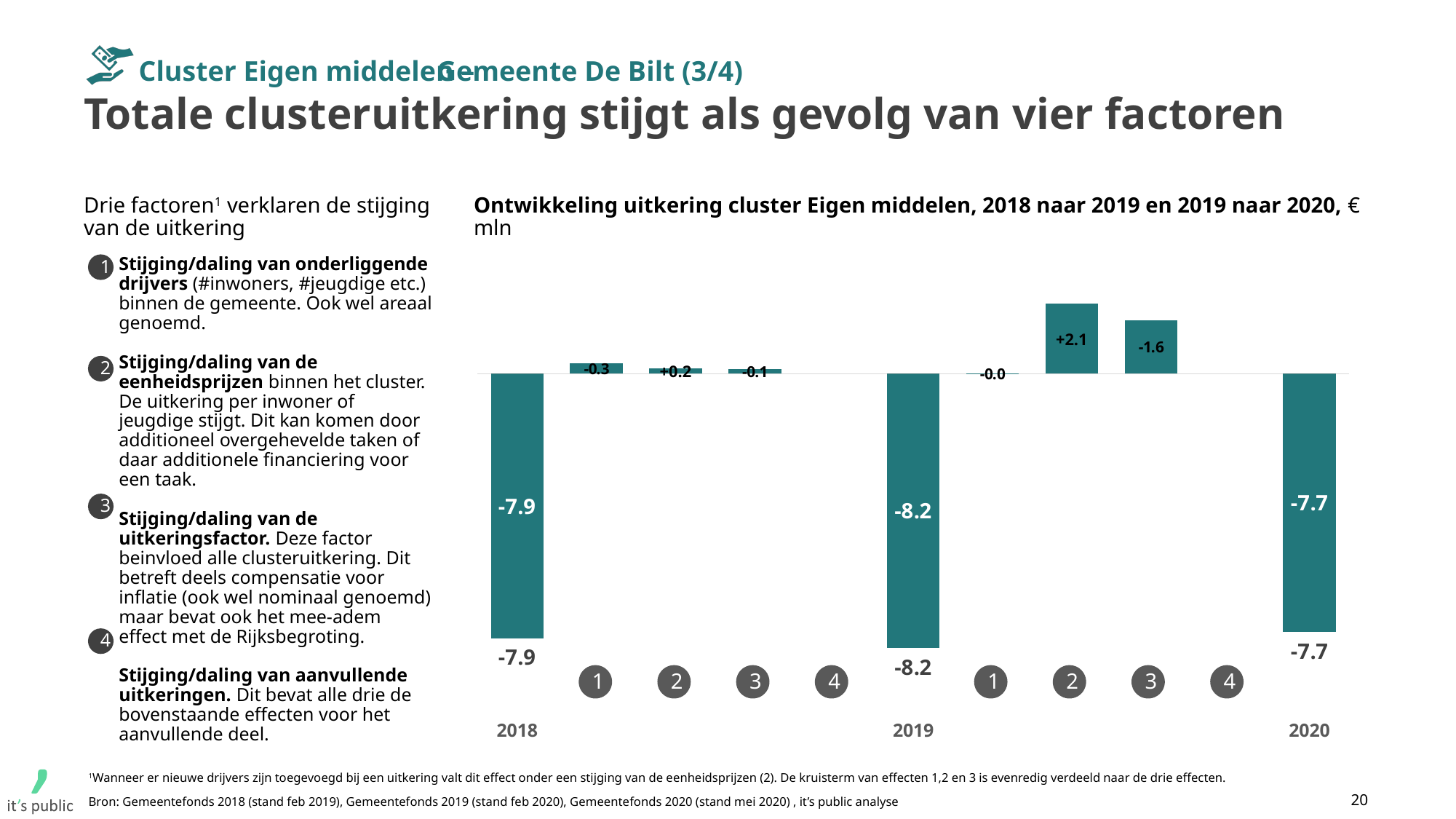
What is the value shown for 2019 in the chart? -8.2 What is the value of factor 3 between 2019 and 2020? -1.6 Which is larger in absolute size: factor 2 between 2019 and 2020 or factor 3 between 2019 and 2020? Factor 2 (+2.1) What is the value of factor 2 between 2019 and 2020? +2.1 What is the value shown for 2020 in the chart? -7.7 What unit is stated in the chart title? € mln What is the value shown for 2018 in the chart? -7.9 What kind of chart is shown on the slide? Bar chart (waterfall) What is the value of factor 2 between 2018 and 2019? +0.2 Which of the three years (2018, 2019, 2020) has the lowest value? 2019 What is the difference between the 2020 value and the 2019 value? 0.5 What is the value of factor 1 between 2018 and 2019? -0.3